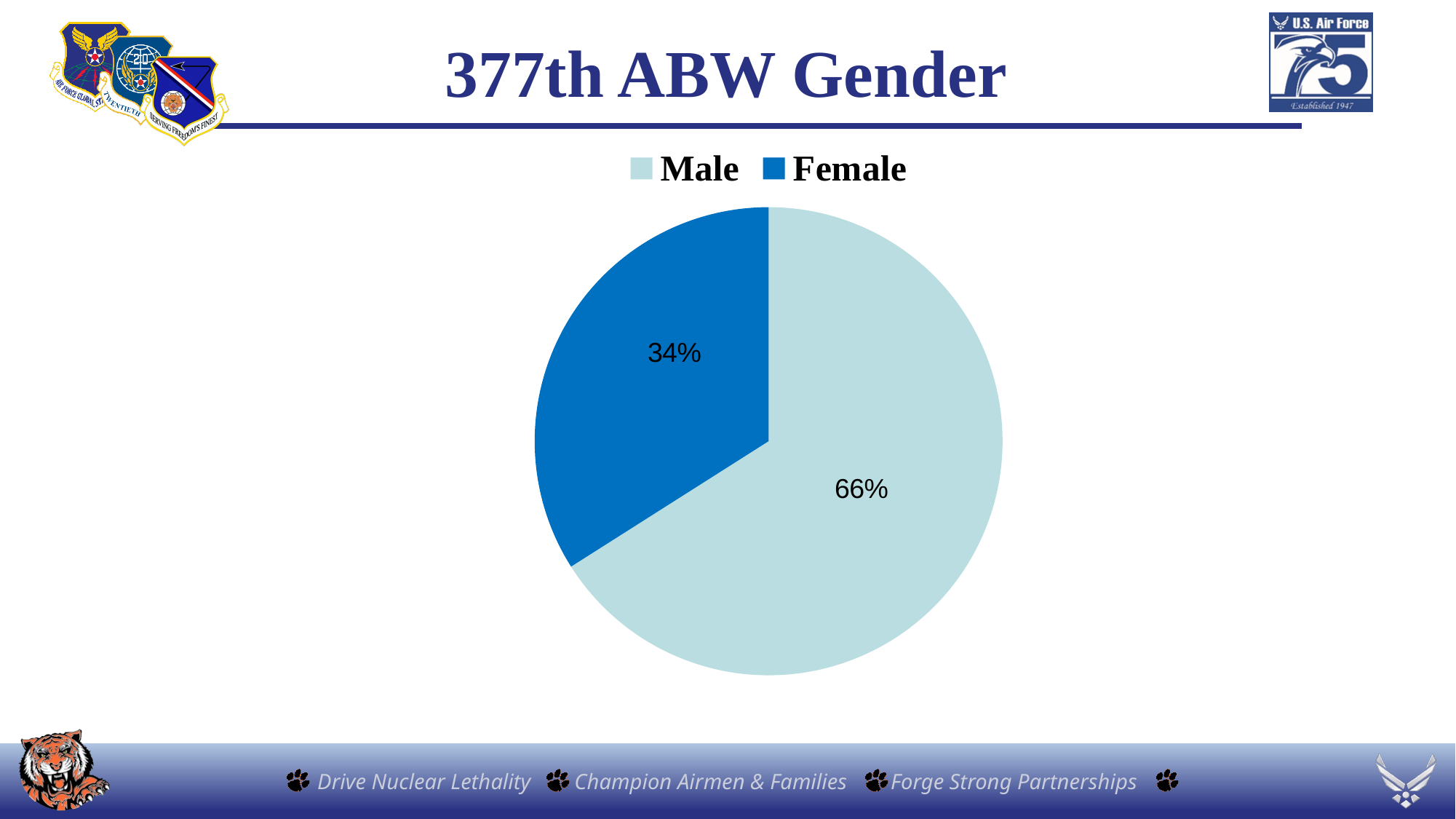
Which category has the smallest share of the pie chart? Female Which is larger, the Male share or the Female share? Male Which colour represents Female in the pie chart? Dark blue Which category has the largest share of the pie chart? Male What percentage of the pie chart is Female? 34% What is the difference in percentage points between the Male and Female shares? 32 How many slices does the pie chart have? 2 What percentage of the pie chart is Male? 66% What share of the pie does the Male slice represent? 66% What kind of chart is shown on the slide? Pie chart What is the title of the slide? 377th ABW Gender How many entries does the legend list? 2